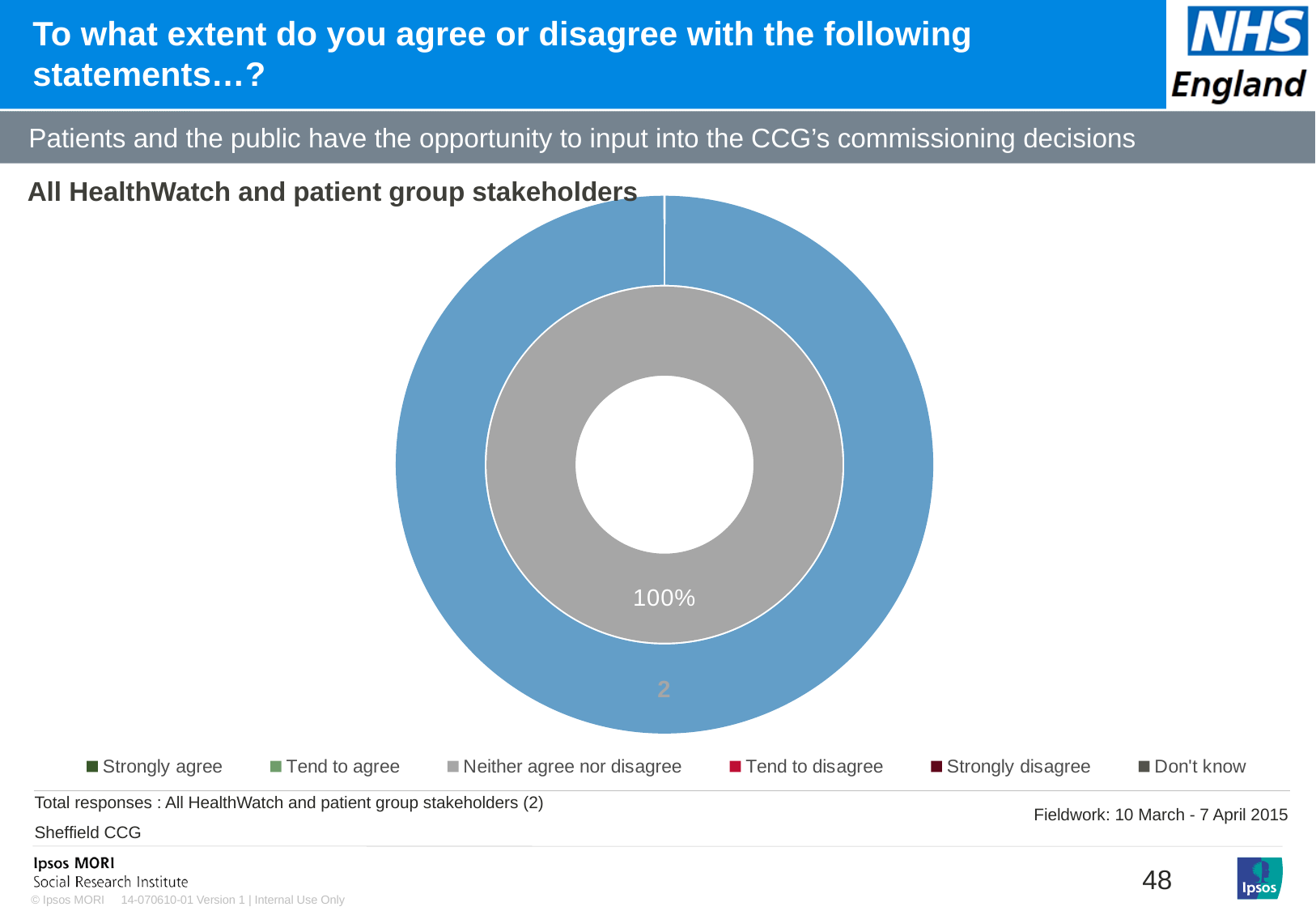
Which response category accounts for the largest share of the chart? Neither agree nor disagree What colour represents 'Neither agree nor disagree' in the legend? Grey What kind of chart is shown on the slide? Doughnut (pie) chart What is the only percentage data label printed on the chart? 100% What share of the chart is labelled for 'Neither agree nor disagree'? 100% How many response categories does the legend list? 6 Which legend entry appears first, at the far left? Strongly agree What is the title of the chart? All HealthWatch and patient group stakeholders Is the share for 'Neither agree nor disagree' greater or less than 50%? greater How many total responses are shown for All HealthWatch and patient group stakeholders? 2